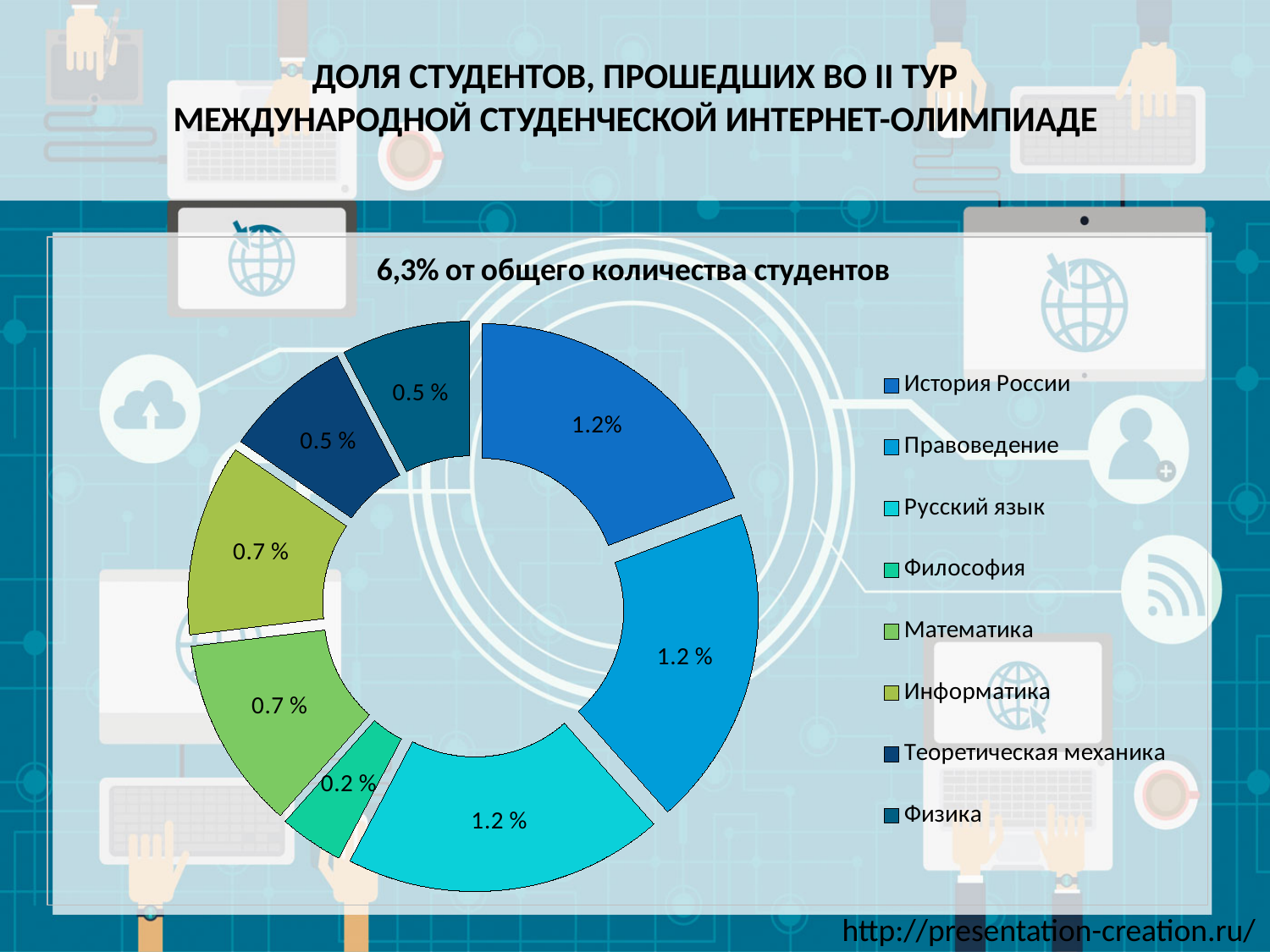
Which legend entry is listed last? Физика Which category has the smallest share? Философия What value is shown for История России? 1.2% What is the title of the chart? 6,3% от общего количества студентов What value is shown for Физика? 0.5 % How many categories are shown in the chart? 8 What value is shown for Математика? 0.7 % What value is shown for Русский язык? 1.2 % What is the difference between the values for Математика and Физика? 0.2 % Which is larger, the value for Информатика or the value for Теоретическая механика? Информатика What kind of chart is shown on the slide? Doughnut (pie) chart What value is shown for Философия? 0.2 %